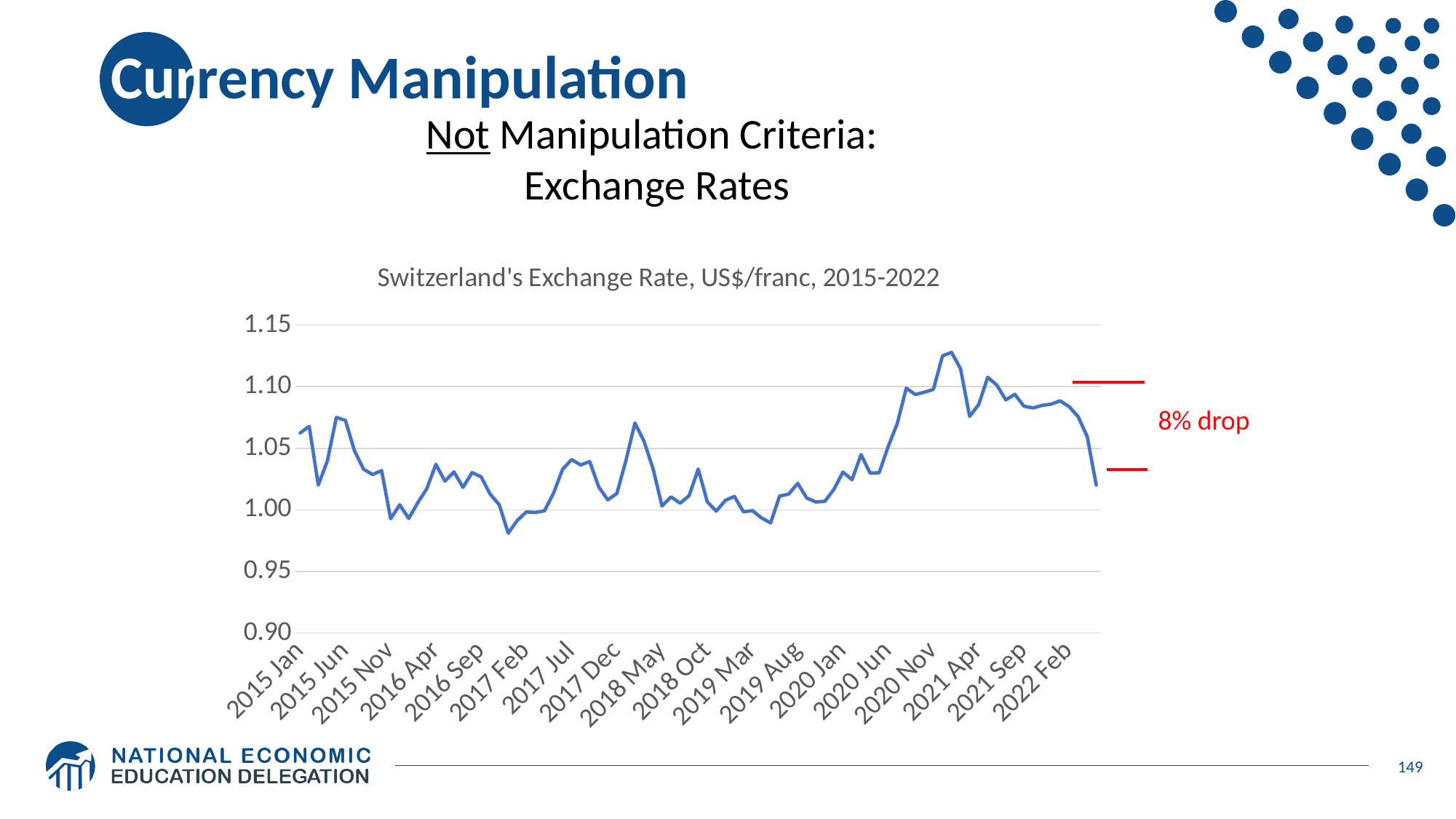
Is the value for 2015 Jan greater or less than 1.05? greater Is the highest point on the line greater or less than 1.10? greater Which is larger, the value for 2015 Jun or the value for 2017 Feb? 2015 Jun What is the title of the chart? Switzerland's Exchange Rate, US$/franc, 2015-2022 What does the red annotation to the right of the chart say? 8% drop Does the exchange rate rise or fall between 2020 Jan and 2020 Nov? Rise Which is larger, the value for 2020 Nov or the value for 2019 Mar? 2020 Nov What kind of chart is shown on the slide? Line chart Is the value for 2020 Nov greater or less than 1.05? greater How many date labels are shown on the x axis? 18